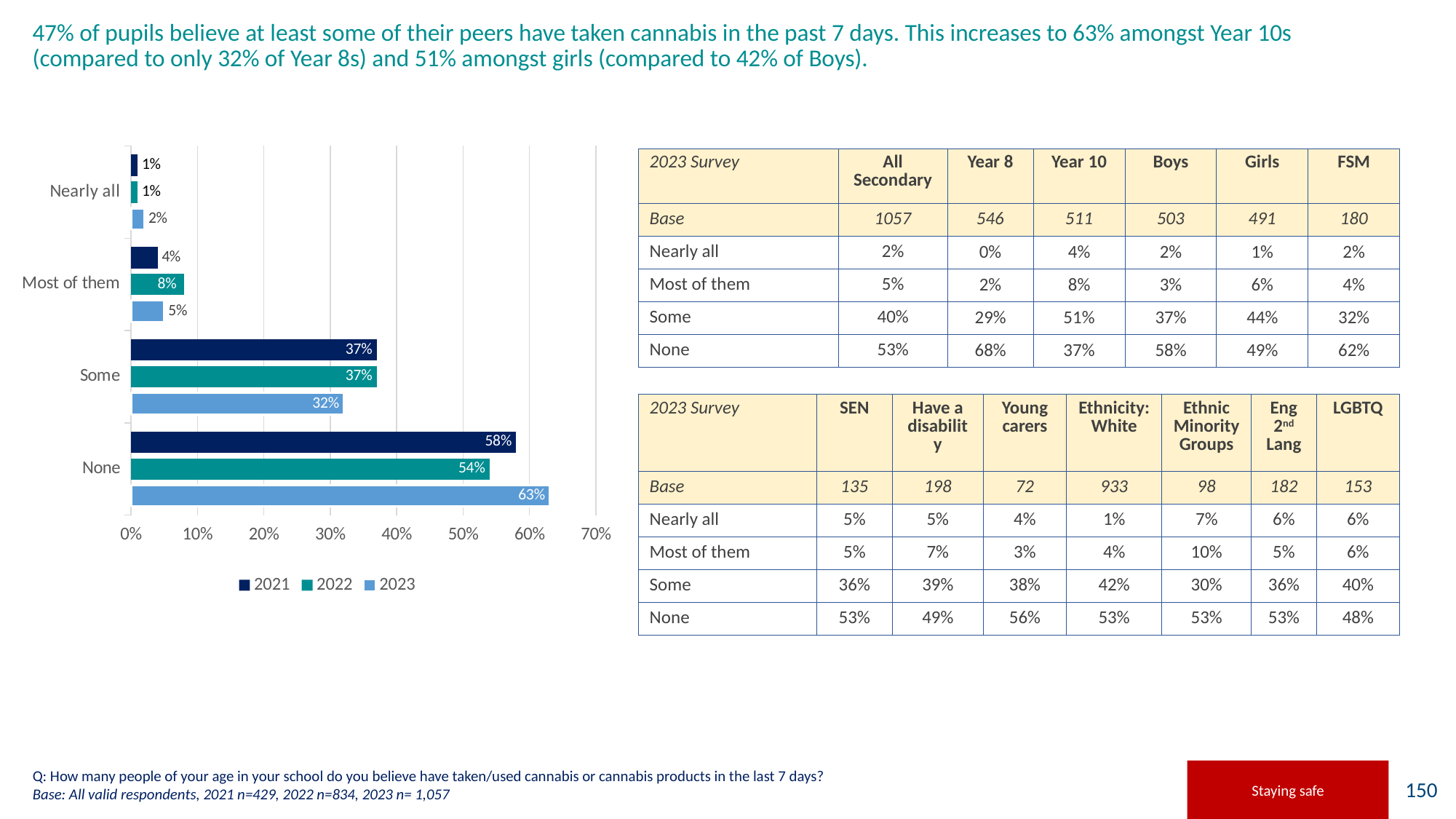
Which series is shown in the lightest blue colour in the chart legend? 2023 Which is larger in the chart: the 2021 value for None or the 2022 value for None? 2021 How many categories are shown on the chart? 4 What is the difference between the 2023 and 2022 values for None in the chart? 9% Which category has the highest 2023 value in the chart? None How many series does the chart legend list? 3 Which category has the lowest 2021 value in the chart? Nearly all What is the difference between the 2021 and 2023 values for Some in the chart? 5% What kind of chart is shown on the slide? bar chart What is the 2023 value for None in the chart? 63% What is the 2022 value for Most of them in the chart? 8% What is the 2021 value for Some in the chart? 37%